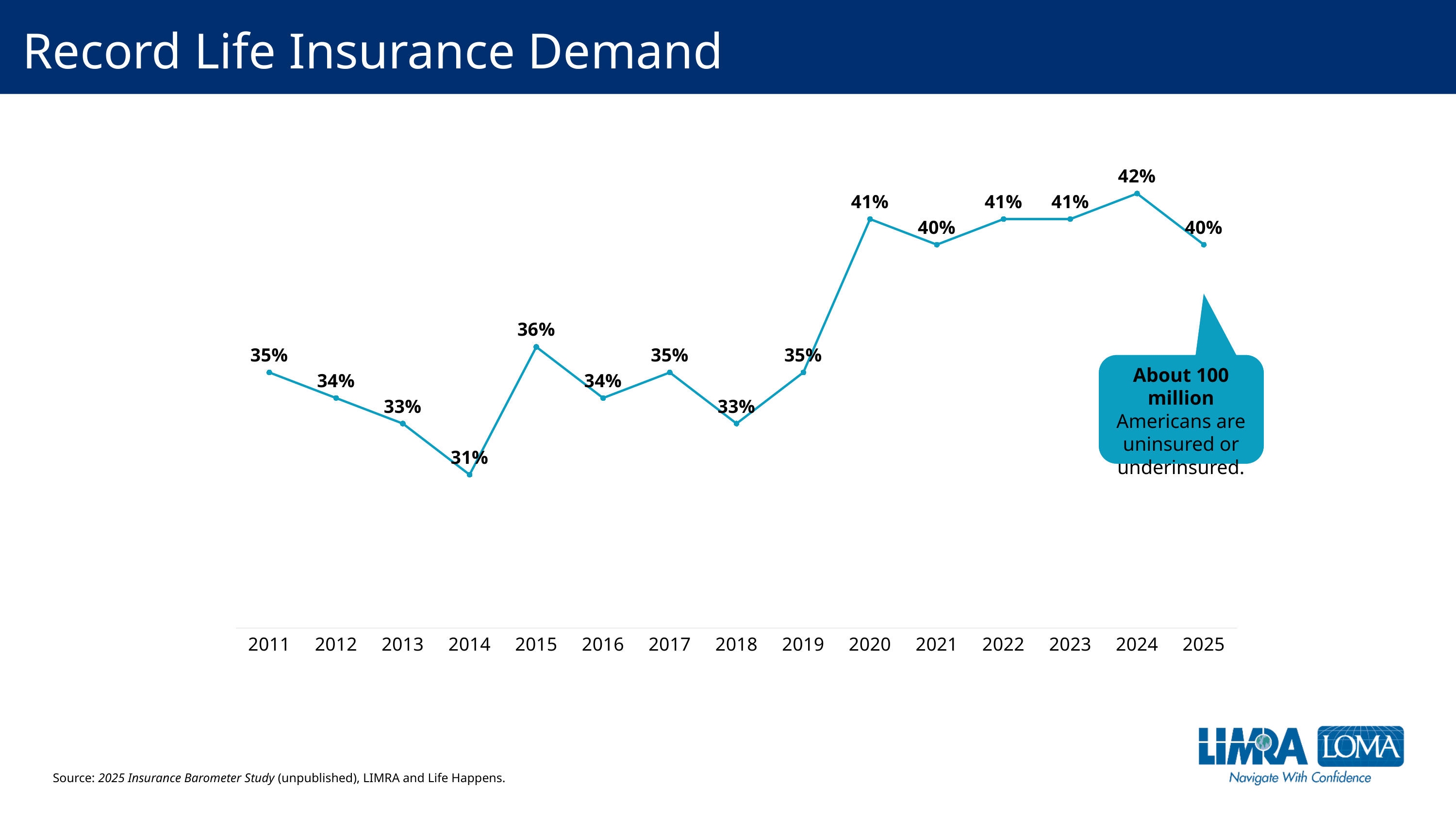
What is the value for 2015? 36% What is the difference between the values for 2020 and 2019? 6% Which year has the highest value? 2024 Which is larger, the value for 2015 or the value for 2018? 2015 What is the value for 2020? 41% What is the difference between the values for 2024 and 2014? 11% What is the value for 2014? 31% How many years are plotted on the chart? 15 What kind of chart is shown on the slide? Line chart What is the value for 2025? 40% What is the title of the slide? Record Life Insurance Demand Which year has the lowest value? 2014